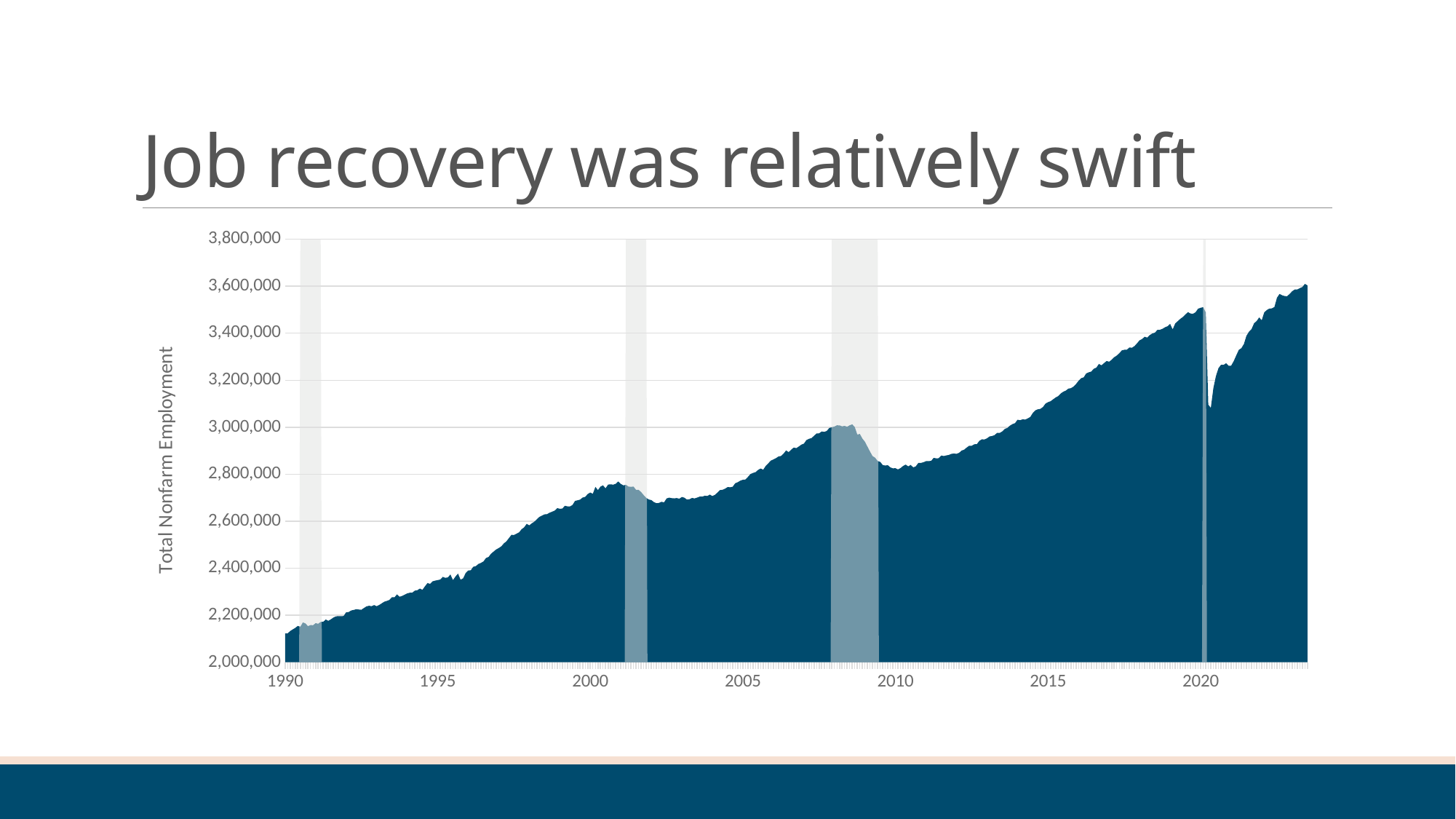
Is the value for Total Nonfarm Employment in 2010 greater or less than 3,000,000? less Is the value for Total Nonfarm Employment in 2015 greater or less than 3,000,000? greater What is the label on the vertical axis of the chart? Total Nonfarm Employment Which is larger, Total Nonfarm Employment in 2005 or in 2015? 2015 What is the title of the slide? Job recovery was relatively swift What kind of chart is shown on the slide? Area chart Is the value for Total Nonfarm Employment in 1990 greater or less than 2,200,000? less Overall, does Total Nonfarm Employment rise or fall from 1990 to the end of the series? rise Does Total Nonfarm Employment rise or fall between 2008 and 2010? fall